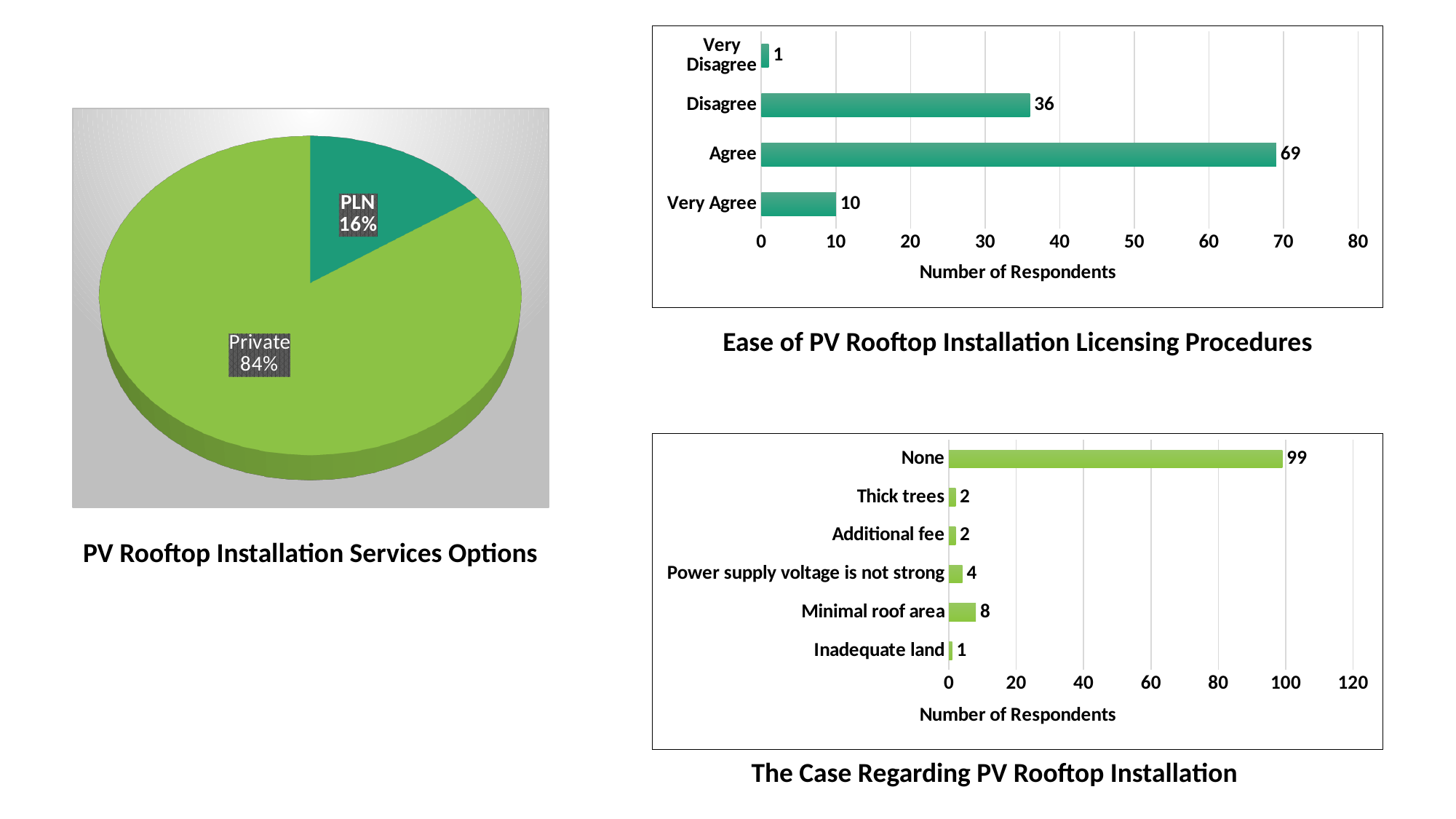
In the 'Ease of PV Rooftop Installation Licensing Procedures' chart, how many respondents chose Agree? 69 What kind of chart is 'Ease of PV Rooftop Installation Licensing Procedures'? Bar chart In 'The Case Regarding PV Rooftop Installation' chart, how many respondents chose None? 99 In the 'Ease of PV Rooftop Installation Licensing Procedures' chart, what is the difference between Agree and Disagree? 33 In 'The Case Regarding PV Rooftop Installation' chart, which is larger: Minimal roof area or Power supply voltage is not strong? Minimal roof area In 'The Case Regarding PV Rooftop Installation' chart, which category has the highest number of respondents? None In 'The Case Regarding PV Rooftop Installation' chart, how many categories are shown? 6 In the 'PV Rooftop Installation Services Options' pie chart, what share does Private have? 84% What kind of chart is 'PV Rooftop Installation Services Options'? Pie chart In the 'PV Rooftop Installation Services Options' pie chart, what share does PLN have? 16% In the 'Ease of PV Rooftop Installation Licensing Procedures' chart, how many categories are shown? 4 In the 'Ease of PV Rooftop Installation Licensing Procedures' chart, which category has the lowest number of respondents? Very Disagree